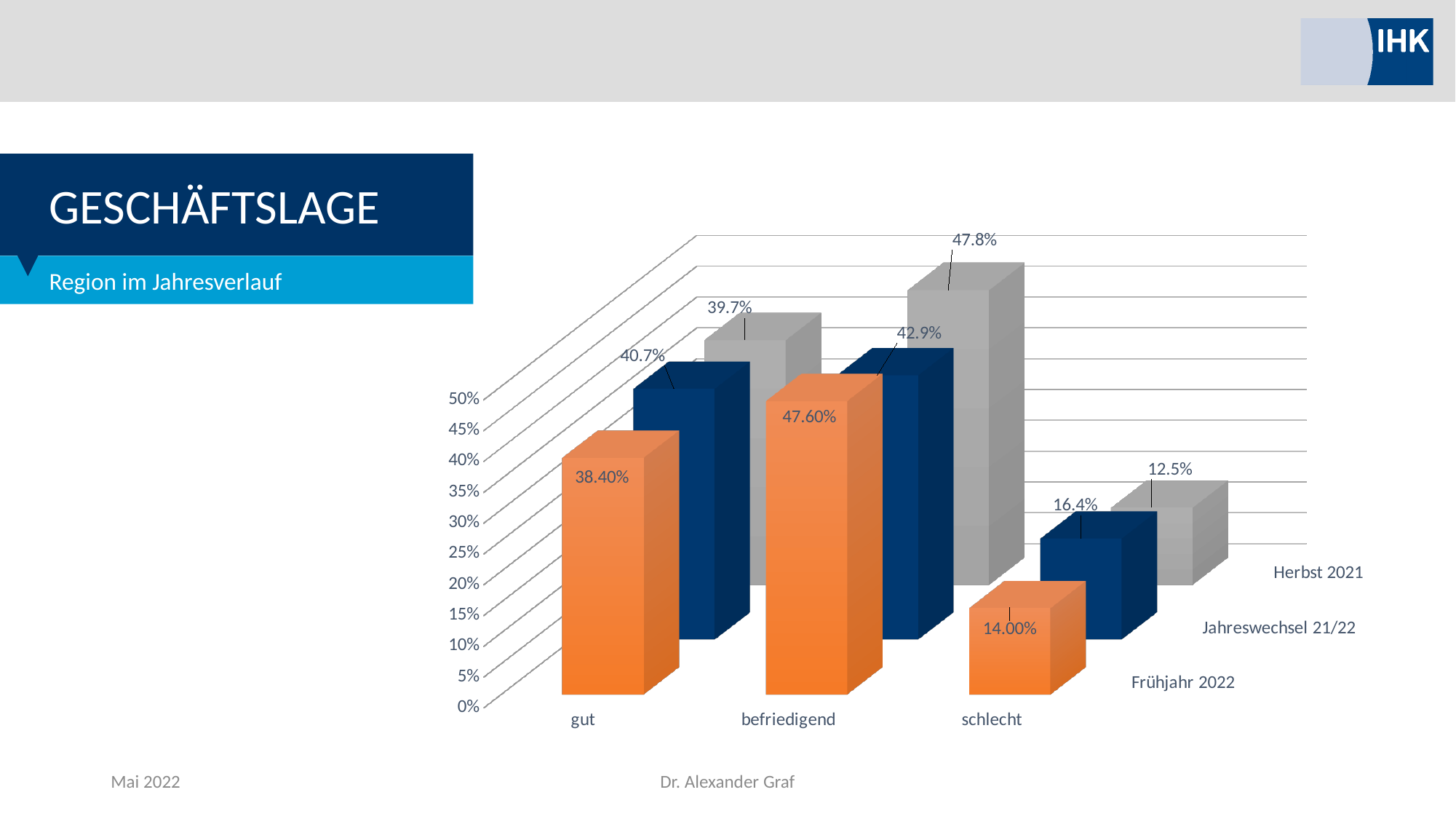
What is the value for "befriedigend" in the Herbst 2021 series? 47.8% Which category has the lowest value in the Herbst 2021 series? schlecht How many data series does the chart show? 3 Which category has the highest value in the Frühjahr 2022 series? befriedigend Which is larger for "gut": the Jahreswechsel 21/22 value or the Frühjahr 2022 value? Jahreswechsel 21/22 What kind of chart is shown on the slide? bar chart What is the value for "schlecht" in the Jahreswechsel 21/22 series? 16.4% What is the title shown in the dark blue box on the slide? GESCHÄFTSLAGE How many categories are shown on the x axis? 3 What is the difference between the Jahreswechsel 21/22 and Herbst 2021 values for "schlecht"? 3.9% What is the value for "gut" in the Frühjahr 2022 series? 38.40% What is the value for "gut" in the Jahreswechsel 21/22 series? 40.7%